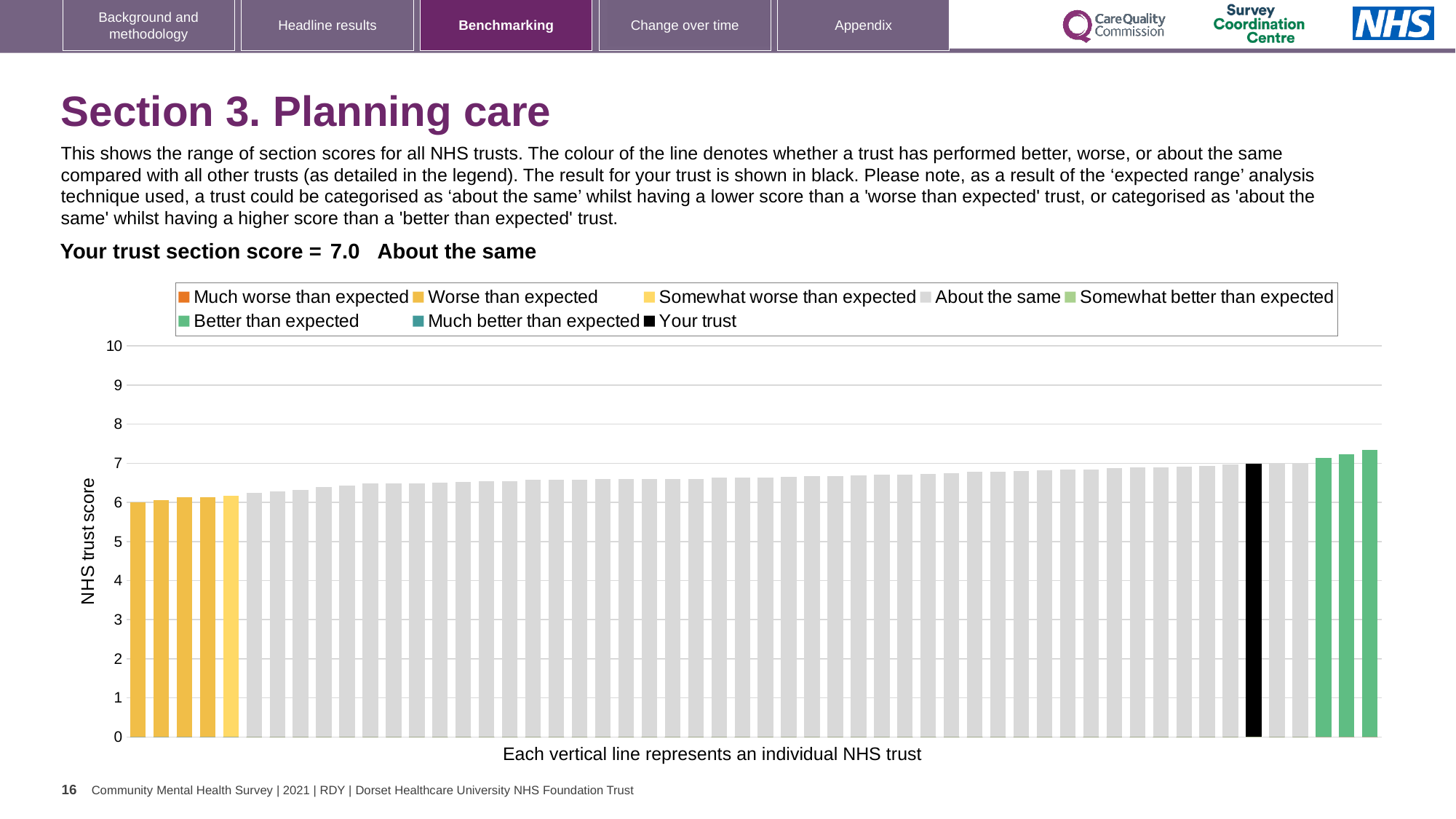
What is the label on the y axis of the chart? NHS trust score Is the black bar (your trust) higher or lower than the green bars to its right? lower What is the section score for your trust shown on the slide? 7.0 Is the value of the black bar (your trust) greater or less than 5? greater How many entries does the chart legend list? 8 Is the value of the tallest bar in the chart greater or less than 8? less Do the bar values rise or fall from left to right along the x axis? rise How many bars are coloured green (better than expected)? 3 Is the value of the shortest bar in the chart greater or less than 5? greater According to the legend, what colour represents your trust? black What kind of chart is shown on the slide? bar chart